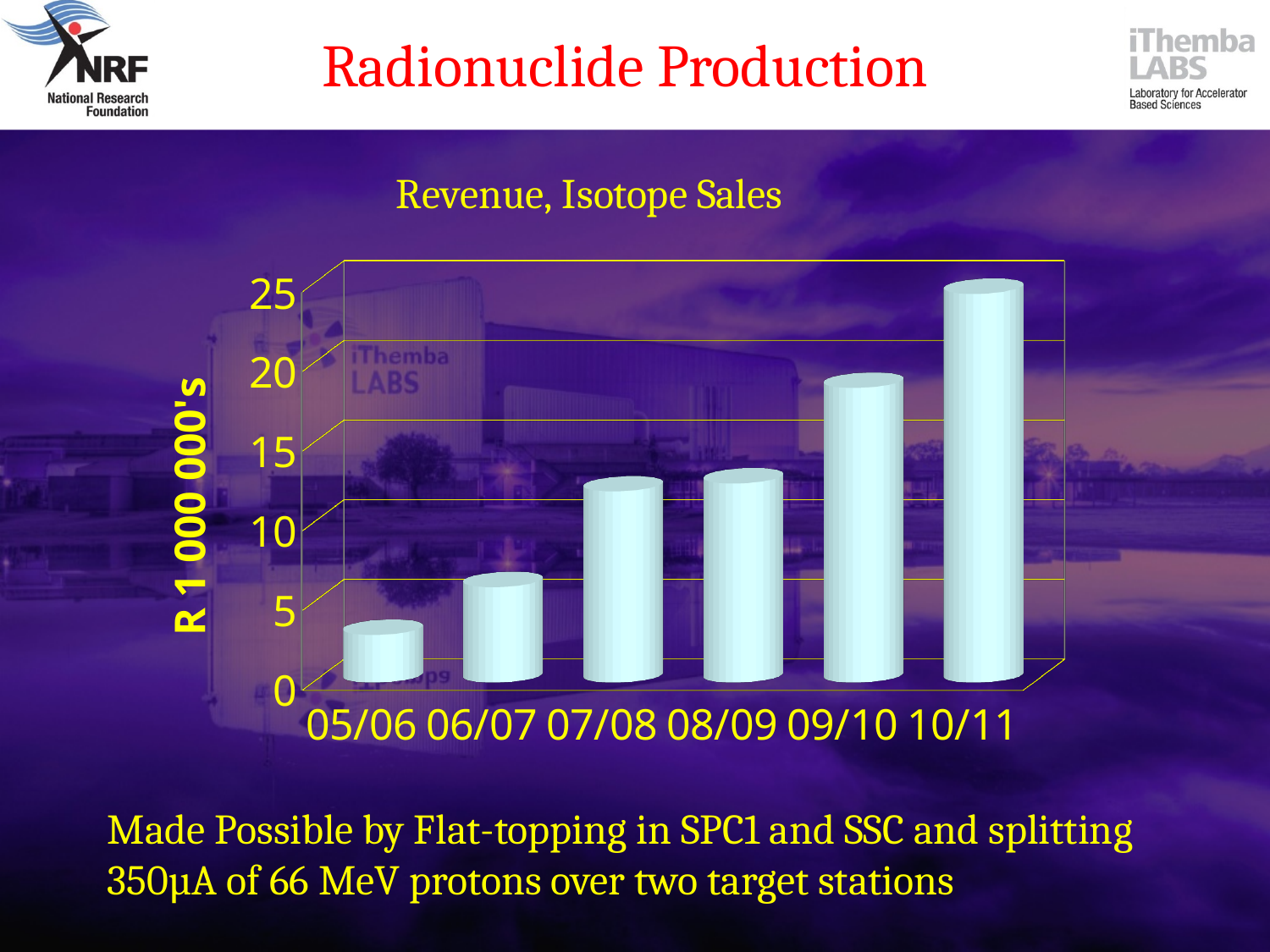
Which year has the highest revenue from isotope sales? 10/11 Do the revenue values rise or fall from 05/06 to 10/11? rise Is the value for 10/11 greater or less than 20? greater How many categories (years) are shown on the x axis of the chart? 6 Is the value for 05/06 greater or less than 5? less What is the title of the chart? Revenue, Isotope Sales Is the value for 09/10 greater or less than 15? greater What is the label on the vertical axis of the chart? R 1 000 000's Which year has the lowest revenue from isotope sales? 05/06 What type of chart is shown on the slide? bar chart Which is larger, the value for 09/10 or the value for 07/08? 09/10